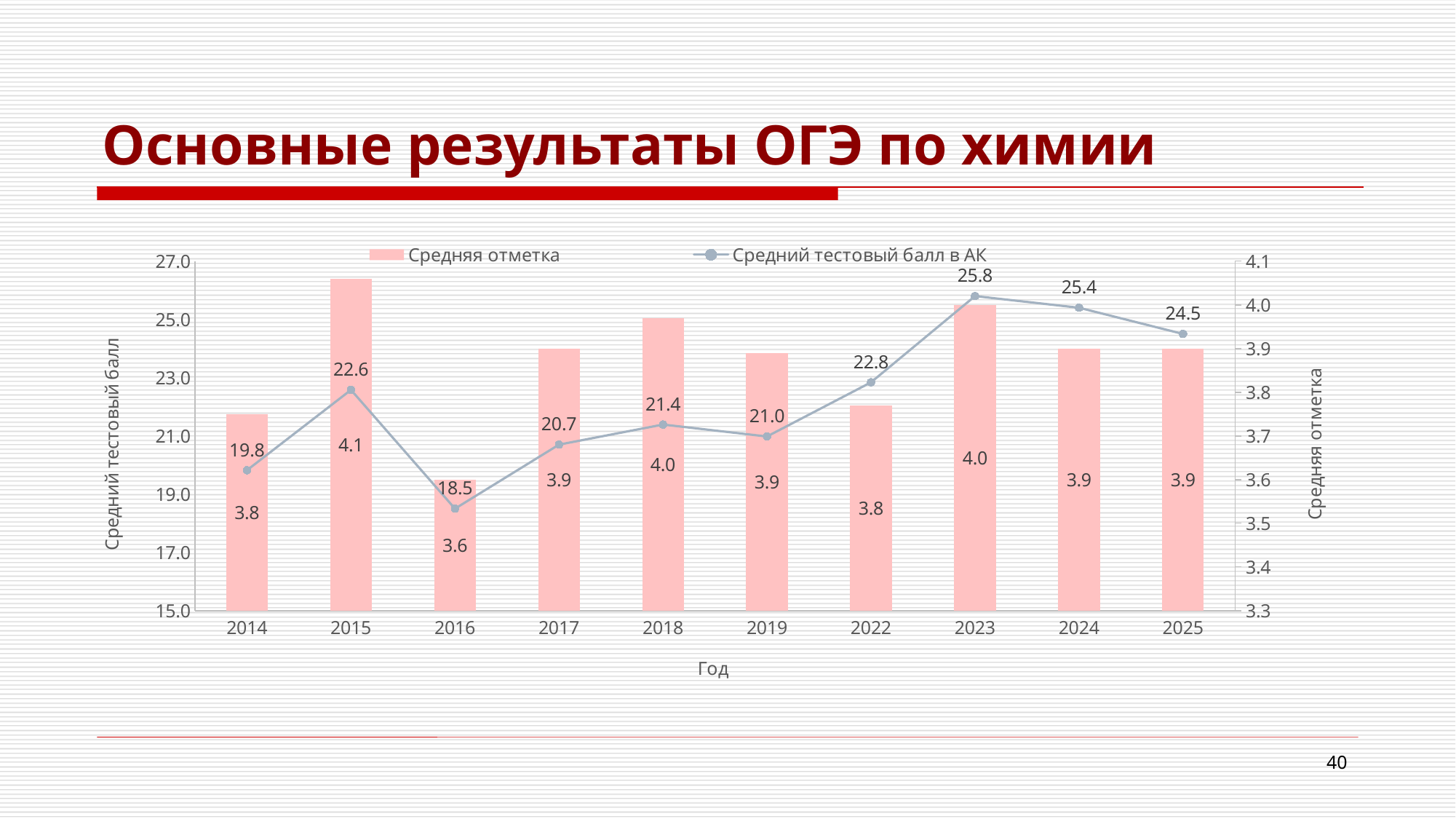
What is the difference between the Средний тестовый балл в АК values for 2023 and 2014? 6.0 What is the value of Средняя отметка for 2016? 3.6 What is the label of the x axis? Год Which year has the highest value of Средняя отметка? 2015 How many years are shown on the x axis? 10 Does the Средний тестовый балл в АК line rise or fall from 2023 to 2025? fall How many series does the legend list? 2 Which year has the highest value of Средний тестовый балл в АК? 2023 What is the value of Средний тестовый балл в АК for 2019? 21.0 Which is larger, the Средний тестовый балл в АК value for 2015 or for 2022? 2022 What is the value of Средний тестовый балл в АК for 2023? 25.8 Which year has the lowest value of Средняя отметка? 2016